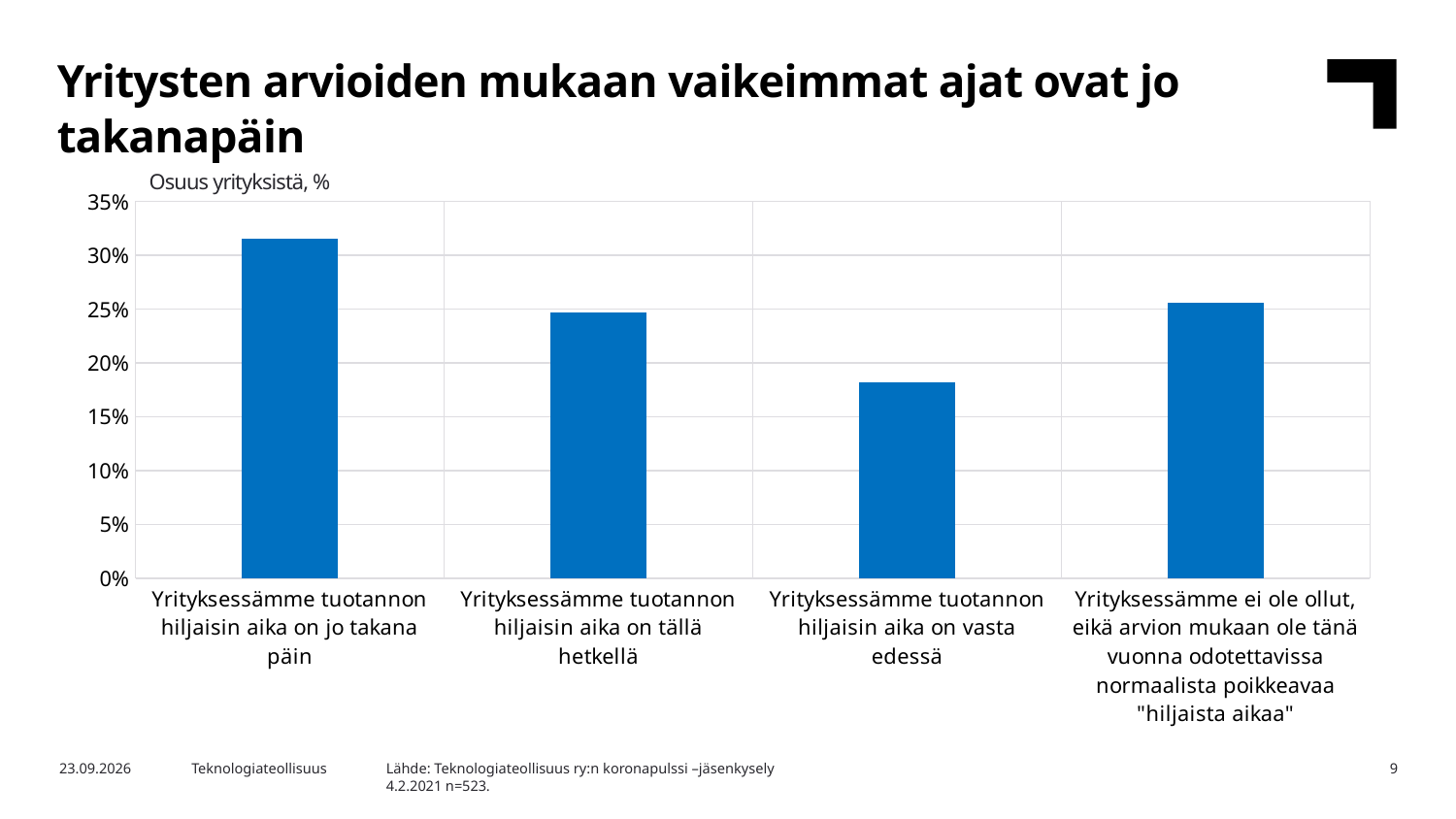
Is the value for "Yrityksessämme ei ole ollut, eikä arvion mukaan ole tänä vuonna odotettavissa normaalista poikkeavaa 'hiljaista aikaa'" greater or less than 25%? greater Is the value for "Yrityksessämme tuotannon hiljaisin aika on vasta edessä" greater or less than 20%? less What kind of chart is shown on the slide? bar chart What is the highest value shown on the vertical axis of the chart? 35% Is the value for "Yrityksessämme tuotannon hiljaisin aika on jo takana päin" greater or less than 30%? greater Which category has the highest value in the chart? Yrityksessämme tuotannon hiljaisin aika on jo takana päin Which is larger: the value for "Yrityksessämme tuotannon hiljaisin aika on tällä hetkellä" or the value for "Yrityksessämme tuotannon hiljaisin aika on vasta edessä"? Yrityksessämme tuotannon hiljaisin aika on tällä hetkellä Which category has the lowest value in the chart? Yrityksessämme tuotannon hiljaisin aika on vasta edessä What is the label shown above the vertical axis of the chart? Osuus yrityksistä, % Which is larger: the value for "Yrityksessämme tuotannon hiljaisin aika on jo takana päin" or the value for "Yrityksessämme tuotannon hiljaisin aika on vasta edessä"? Yrityksessämme tuotannon hiljaisin aika on jo takana päin How many categories are shown on the x axis of the chart? 4